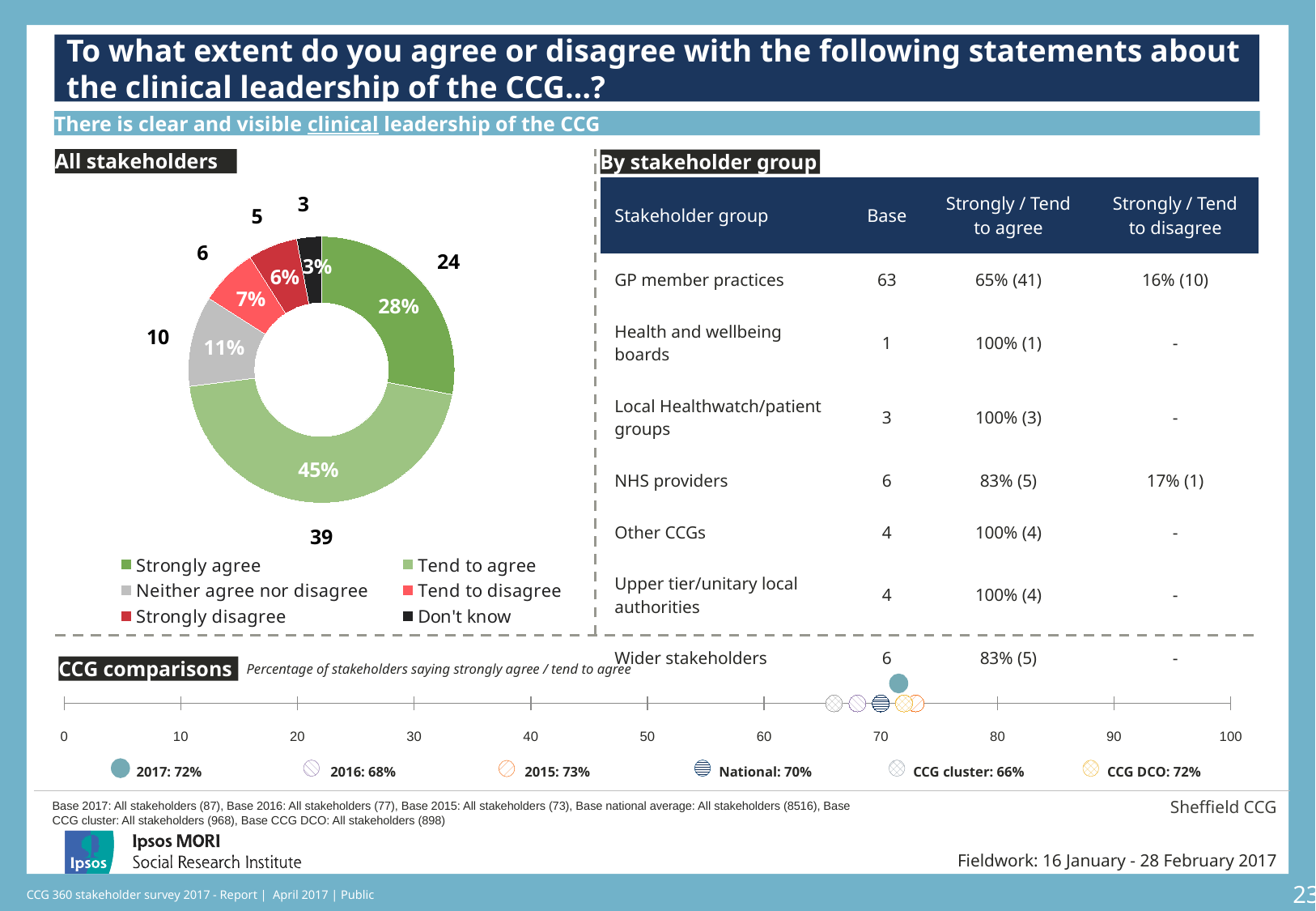
What type of chart is the All stakeholders chart? Donut (pie) chart In the All stakeholders chart, how many stakeholders said they neither agree nor disagree? 10 In the All stakeholders chart, what percentage of stakeholders strongly agree? 28% In the All stakeholders chart, which response category has the largest share? Tend to agree In the CCG comparisons chart, what is the difference between the 2015 and 2016 percentages? 5 percentage points In the All stakeholders chart, what is the difference in percentage points between Tend to agree and Strongly agree? 17 In the CCG comparisons chart, what is the 2017 percentage of stakeholders saying strongly agree / tend to agree? 72% In the All stakeholders chart, what percentage of stakeholders tend to agree? 45% In the CCG comparisons chart, which comparator has the lowest percentage? CCG cluster: 66% How many categories does the legend of the All stakeholders chart list? 6 In the All stakeholders chart, which is larger: Tend to disagree or Strongly disagree? Tend to disagree In the All stakeholders chart, which response category has the smallest share? Don't know